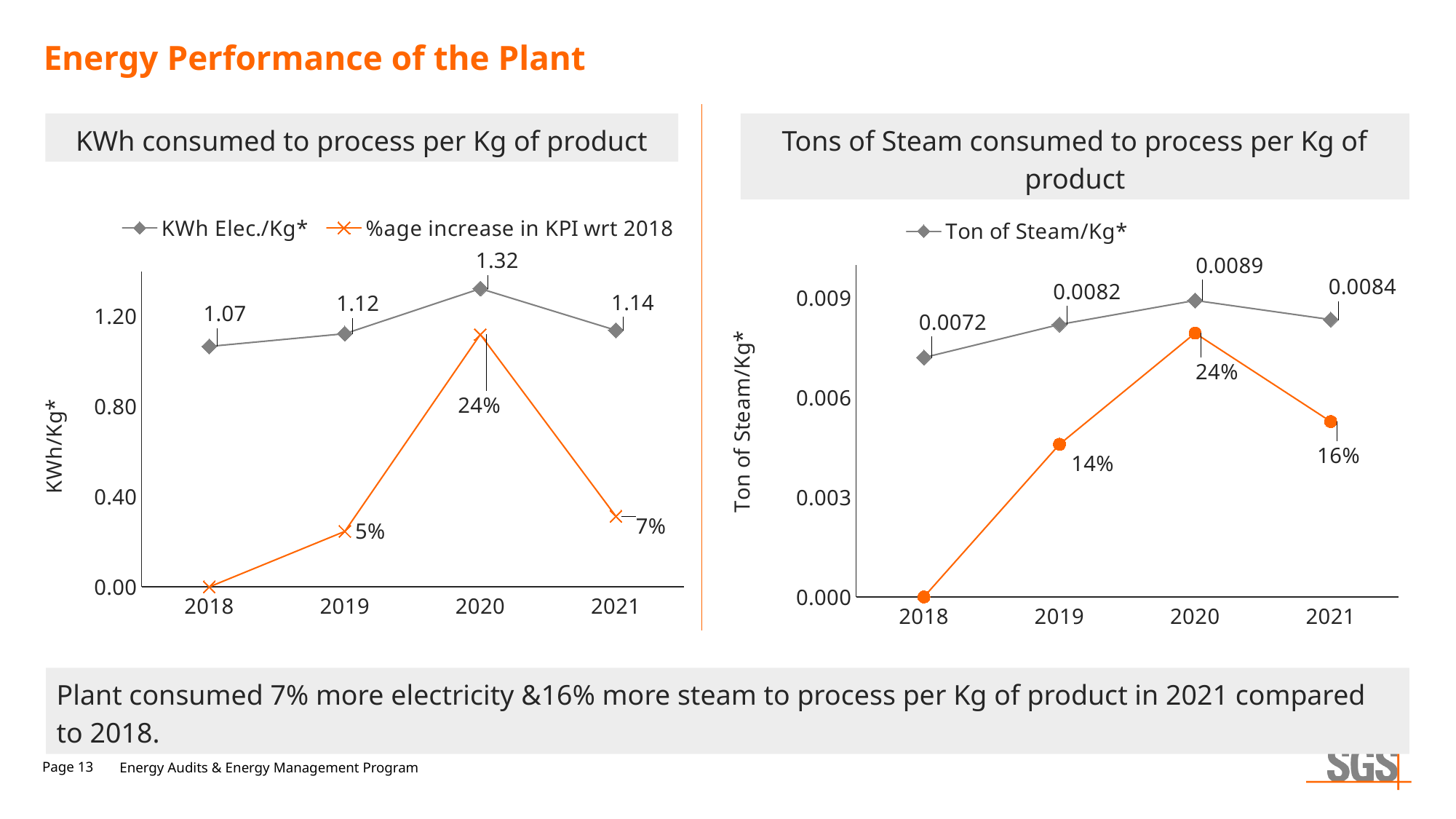
In the 'Tons of Steam consumed to process per Kg of product' chart, what is the Ton of Steam/Kg* value for 2019? 0.0082 In the 'Tons of Steam consumed to process per Kg of product' chart, which year has the highest Ton of Steam/Kg* value? 2020 In the 'Tons of Steam consumed to process per Kg of product' chart, how many years are shown on the x axis? 4 In the 'Tons of Steam consumed to process per Kg of product' chart, is the Ton of Steam/Kg* value for 2021 greater or less than 0.0072 for 2018? greater In the 'KWh consumed to process per Kg of product' chart, how many series does the legend list? 2 In the 'KWh consumed to process per Kg of product' chart, which year has the highest KWh Elec./Kg* value? 2020 In the 'KWh consumed to process per Kg of product' chart, what is the difference between the KWh Elec./Kg* values for 2020 and 2019? 0.20 In the 'KWh consumed to process per Kg of product' chart, which year has the lowest KWh Elec./Kg* value? 2018 In the 'KWh consumed to process per Kg of product' chart, what is the KWh Elec./Kg* value for 2018? 1.07 In the 'KWh consumed to process per Kg of product' chart, what is the %age increase in KPI wrt 2018 for 2021? 7% In the 'KWh consumed to process per Kg of product' chart, what is the KWh Elec./Kg* value for 2020? 1.32 What kind of chart is the 'Tons of Steam consumed to process per Kg of product' chart? Line chart